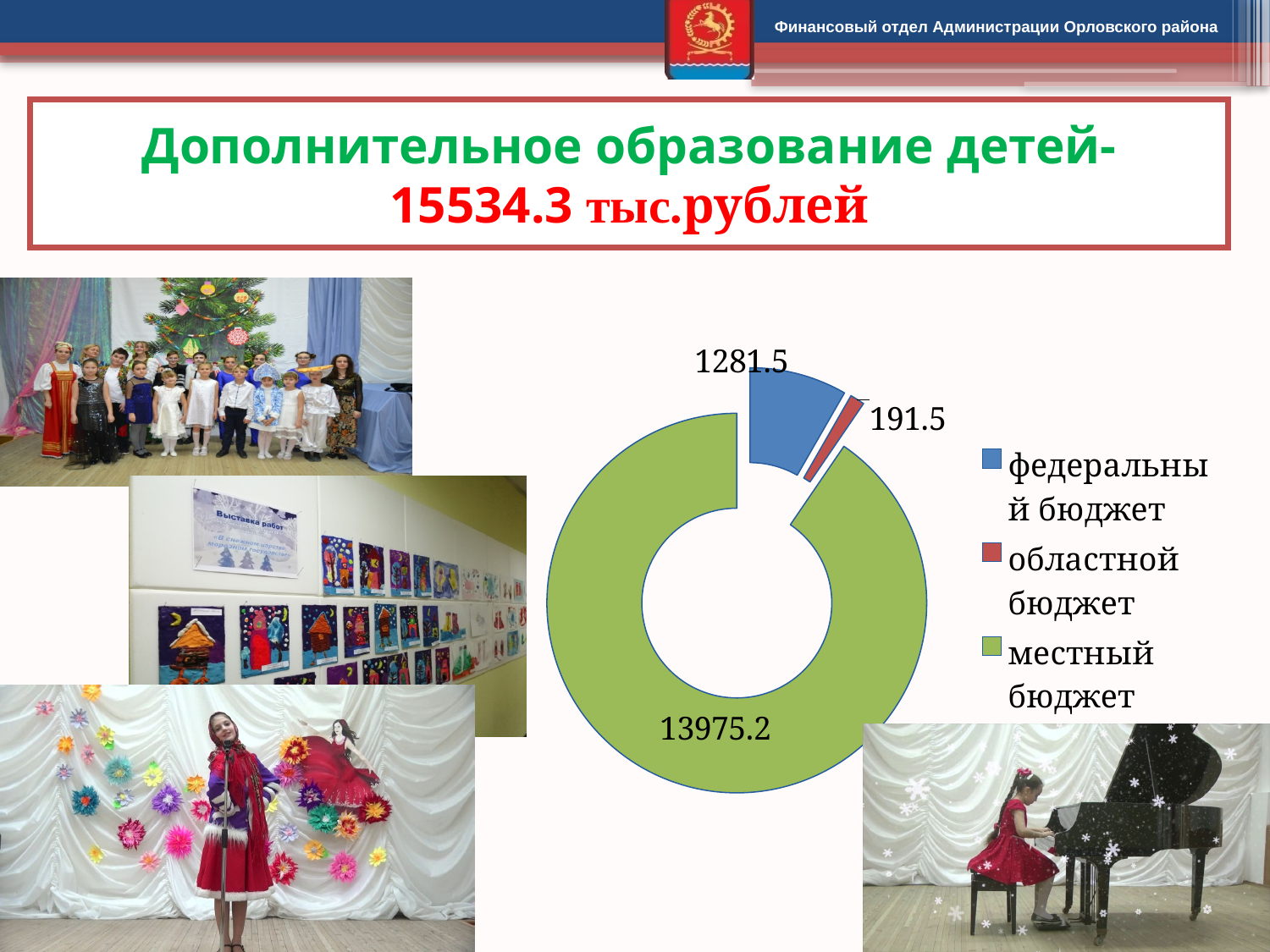
How many slices does the chart have? 3 Which budget source has the smallest value in the chart? областной бюджет What is the difference between the values for федеральный бюджет and областной бюджет? 1090 Which budget source has the largest value in the chart? местный бюджет Which is larger: the value for федеральный бюджет or the value for областной бюджет? федеральный бюджет What is the difference between the values for местный бюджет and федеральный бюджет? 12693.7 What kind of chart is shown on the slide? doughnut chart What is the value for областной бюджет in the chart? 191.5 How many entries does the chart legend list? 3 What colour is the slice for местный бюджет? green What is the value for федеральный бюджет in the chart? 1281.5 What is the value for местный бюджет in the chart? 13975.2